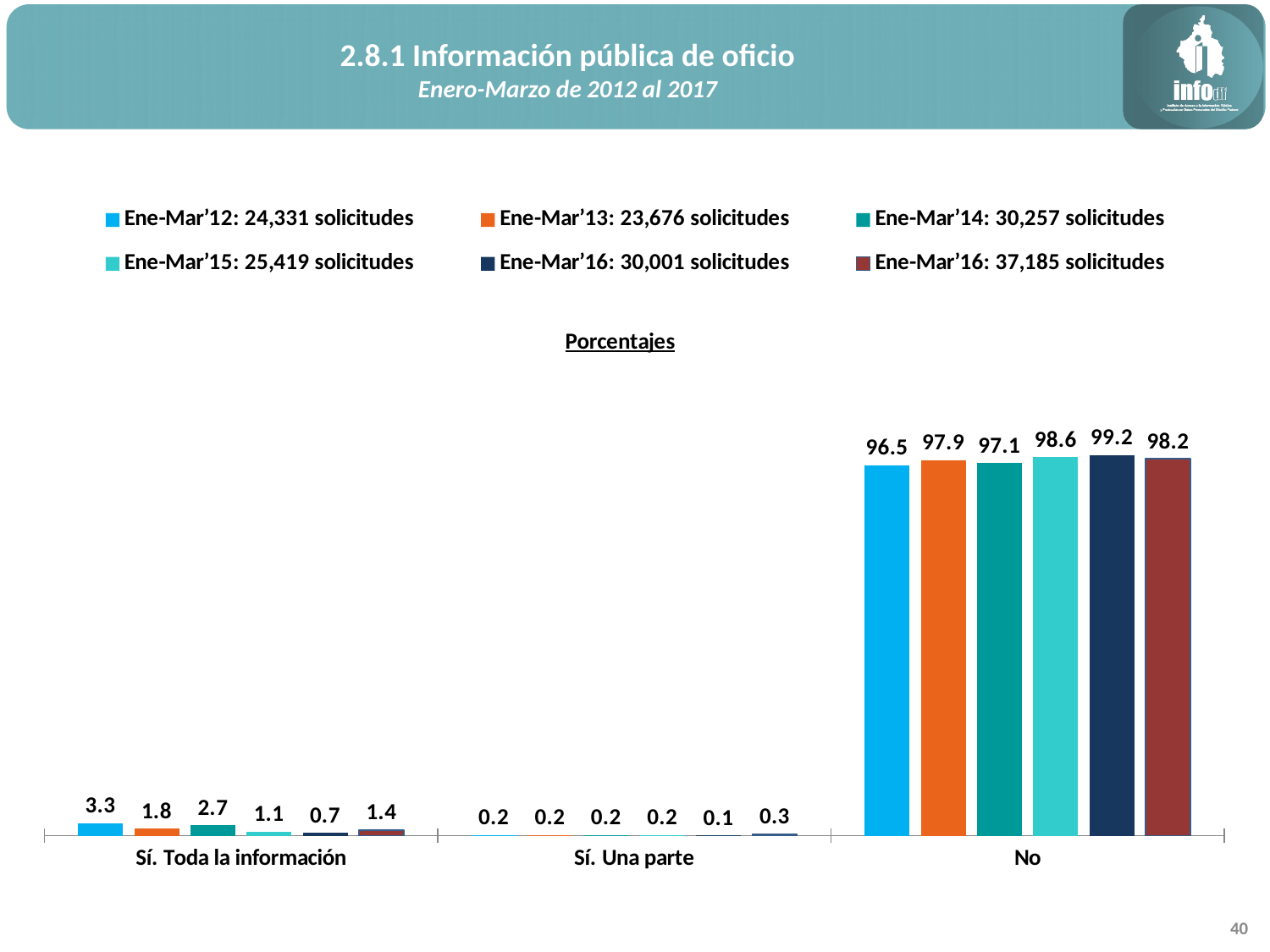
How many series does the legend list? 6 What is the value for Ene-Mar'14 in the "Sí. Toda la información" category? 2.7 What is the value for Ene-Mar'13 in the "Sí. Toda la información" category? 1.8 In the "Sí. Toda la información" category, which is larger: the Ene-Mar'12 value or the Ene-Mar'14 value? Ene-Mar'12 What is the value for Ene-Mar'12 in the "No" category? 96.5 What is the difference between the Ene-Mar'12 and Ene-Mar'15 values in the "Sí. Toda la información" category? 2.2 What kind of chart is shown on the slide? Bar chart How many categories are shown on the x axis of the chart? 3 What is the difference between the Ene-Mar'13 and Ene-Mar'12 values in the "No" category? 1.4 Which series has the highest value in the "No" category? Ene-Mar'16: 30,001 solicitudes What is the value for Ene-Mar'15 in the "Sí. Una parte" category? 0.2 Which series has the lowest value in the "Sí. Toda la información" category? Ene-Mar'16: 30,001 solicitudes